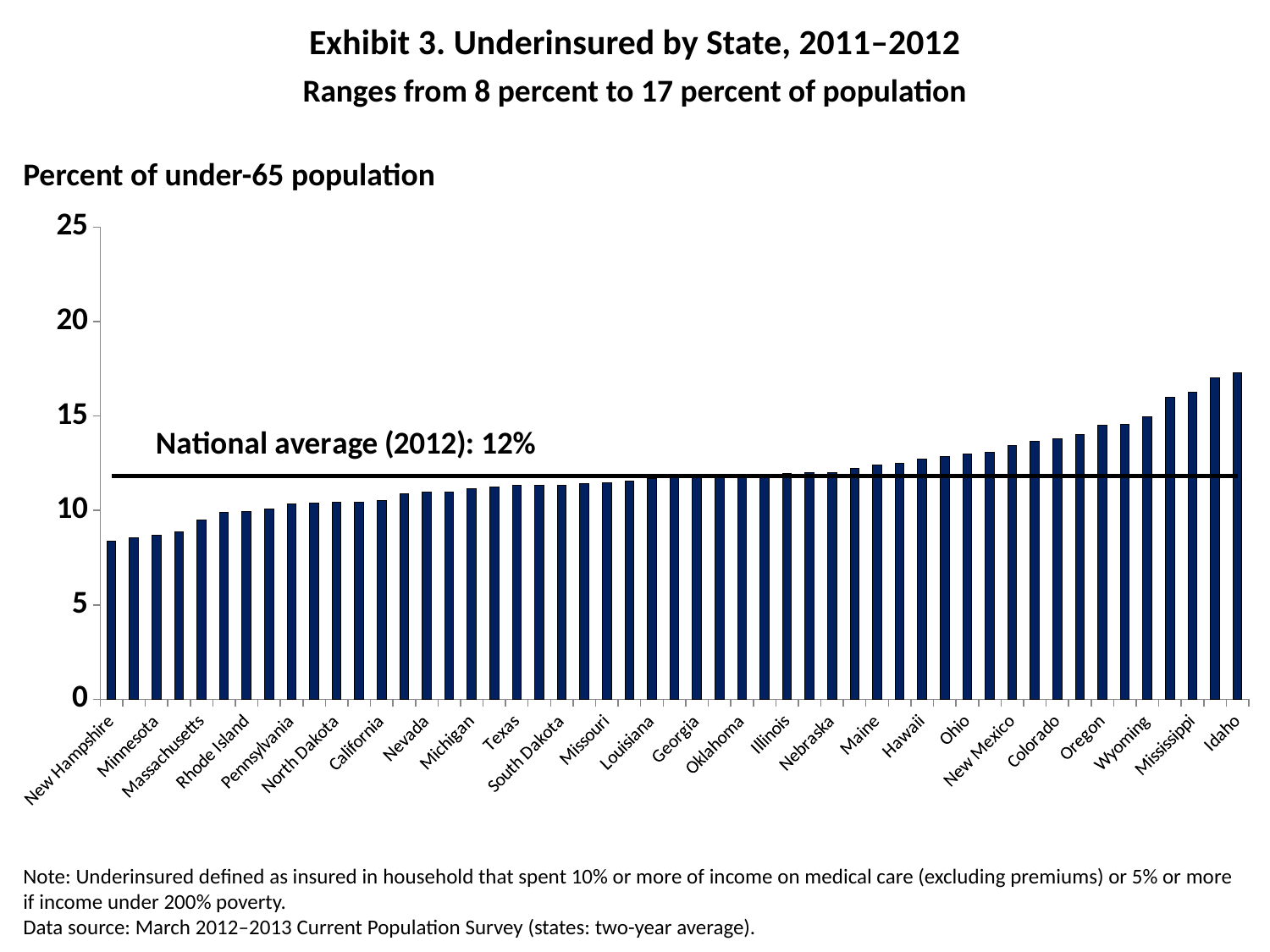
Is the value for New Hampshire greater or less than 10? less Which state has the highest underinsured percentage? Idaho Is the value for Idaho greater or less than 15? greater Which has a larger underinsured percentage, Oregon or Minnesota? Oregon Is the value for Colorado greater or less than 15? less Which state has the lowest underinsured percentage? New Hampshire Do the bar values rise or fall moving from left to right across the states? rise What kind of chart is shown on the slide? bar chart What national average (2012) value is marked by the horizontal line on the chart? 12% What is the label describing the measure on the vertical axis of the chart? Percent of under-65 population